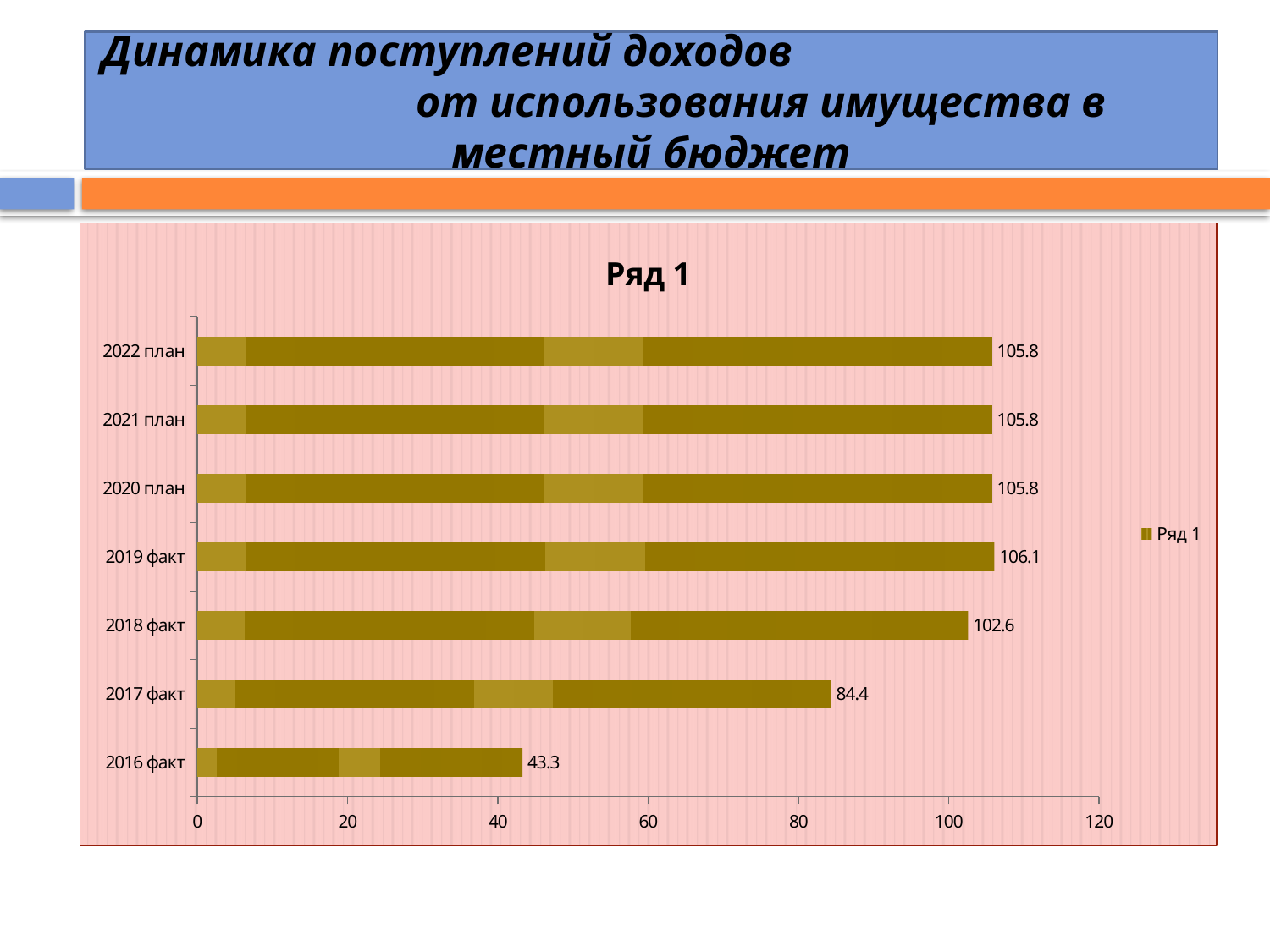
What is the value for 2018 факт? 102.6 How many categories are shown in the chart? 7 Which category has the highest value? 2019 факт What is the difference between the values for 2017 факт and 2016 факт? 41.1 Which is larger, the value for 2017 факт or the value for 2018 факт? 2018 факт What is the difference between the values for 2019 факт and 2018 факт? 3.5 What kind of chart is shown on the slide? bar chart What is the value for 2016 факт? 43.3 Which category has the lowest value? 2016 факт What is the value for 2019 факт? 106.1 What is the title of the chart? Ряд 1 What is the value for 2021 план? 105.8